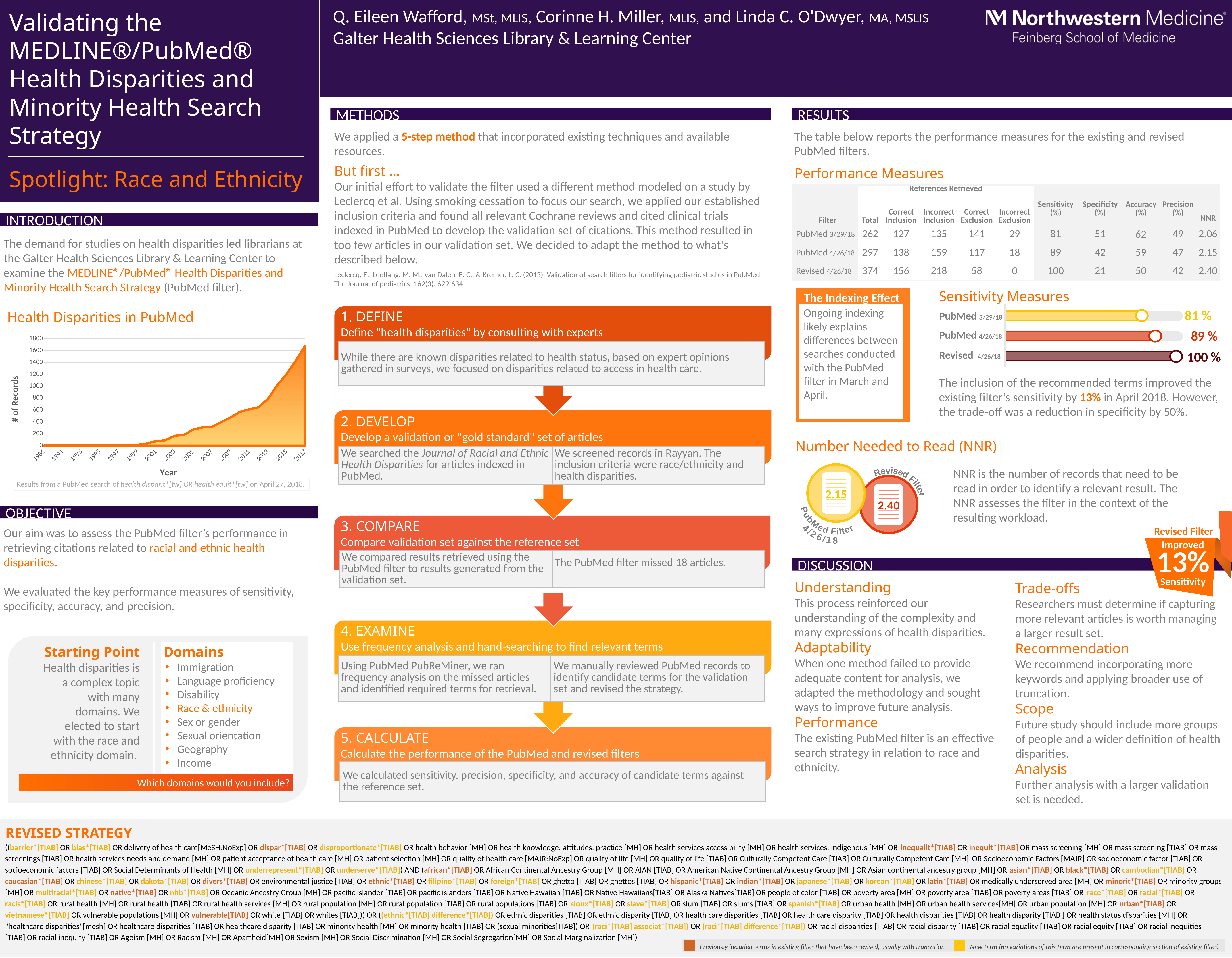
In the 'Health Disparities in PubMed' chart, which year has the highest number of records? 2017 In the 'Health Disparities in PubMed' chart, is the value for 2017 greater or less than 1400? greater In the 'Number Needed to Read (NNR)' graphic, which has the larger NNR, the PubMed Filter 4/26/18 or the Revised Filter? Revised Filter In the 'Sensitivity Measures' chart, what is the sensitivity for PubMed 3/29/18? 81 % In the 'Sensitivity Measures' chart, what is the difference in sensitivity between Revised 4/26/18 and PubMed 3/29/18? 19 % In the 'Sensitivity Measures' chart, which filter has the lowest sensitivity? PubMed 3/29/18 In the 'Health Disparities in PubMed' chart, do the values generally rise or fall from 1986 to 2017? rise In the 'Sensitivity Measures' chart, what is the sensitivity for the Revised 4/26/18 filter? 100 % In the 'Sensitivity Measures' chart, how many filters are shown? 3 In the 'Health Disparities in PubMed' chart, what is the y-axis title? # of Records In the 'Health Disparities in PubMed' chart, is the value for 1999 greater or less than 400? less What kind of chart is the 'Health Disparities in PubMed' chart? area chart